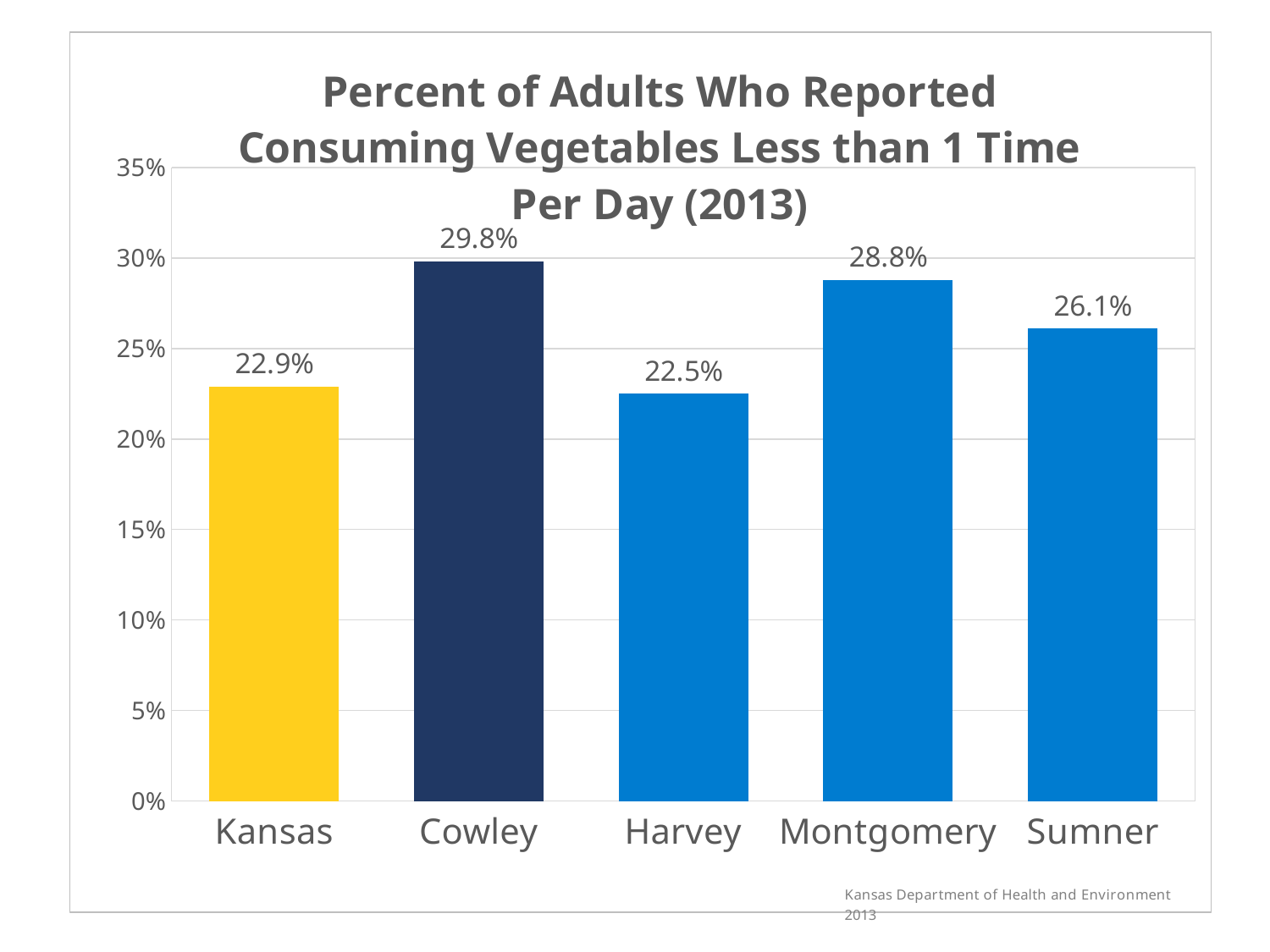
What is the value for Cowley? 29.8% Which category has the lowest value? Harvey What is the value for Kansas? 22.9% Which category has the highest value? Cowley What is the title of the chart? Percent of Adults Who Reported Consuming Vegetables Less than 1 Time Per Day (2013) How many categories are shown on the x axis? 5 What is the value for Sumner? 26.1% What is the difference between the values for Cowley and Harvey? 7.3% Which is larger, the value for Montgomery or the value for Kansas? Montgomery What is the difference between the values for Montgomery and Sumner? 2.7% Is the value for Sumner greater or less than 25%? greater What kind of chart is shown on the slide? bar chart